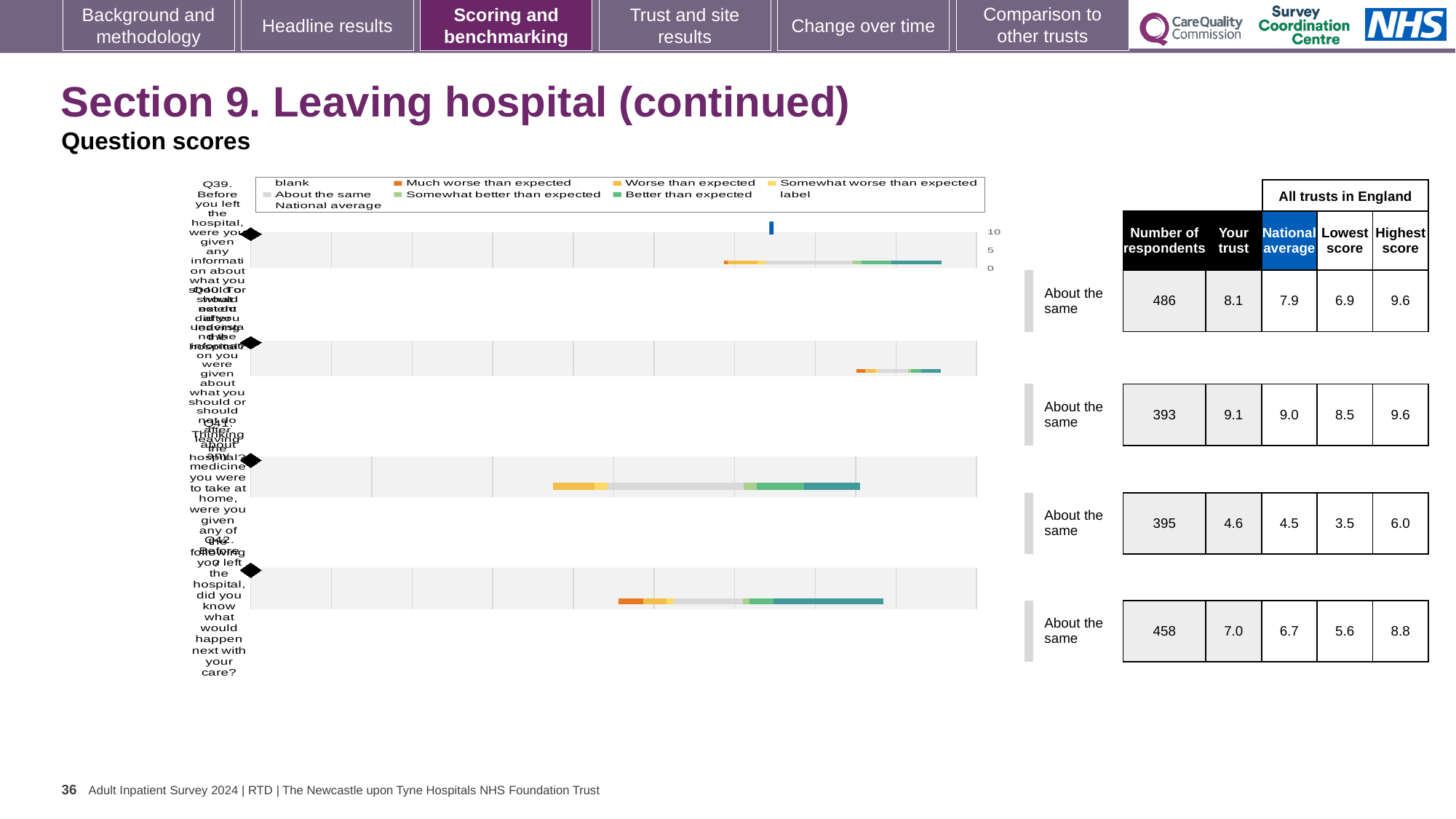
For Q41, what is the difference between the 'Highest score' and the 'Lowest score' in the table? 2.5 What benchmark category is shown for Q41 (Thinking about any medicine you were to take at home)? About the same In the chart legend, what colour represents 'Much worse than expected'? orange What is the lowest 'Your trust' score shown in the table beside the chart? 4.6 What is the highest 'Your trust' score shown in the table beside the chart? 9.1 In the table beside the chart, how many respondents are listed for Q42 (Before you left the hospital, did you know what would happen next with your care)? 458 What kind of chart is shown on the slide? bar chart For Q42, which is larger in the table: the 'Your trust' score or the 'National average'? Your trust (7.0) In the chart legend, what colour represents 'Better than expected'? teal green For Q39, what is the difference between the 'Your trust' score and the 'National average' in the table? 0.2 In the table beside the chart, what is the 'Your trust' score for Q39 (Before you left the hospital, were you given any information about what you should or should not do after leaving hospital)? 8.1 How many question rows (bars) does the chart show? 4